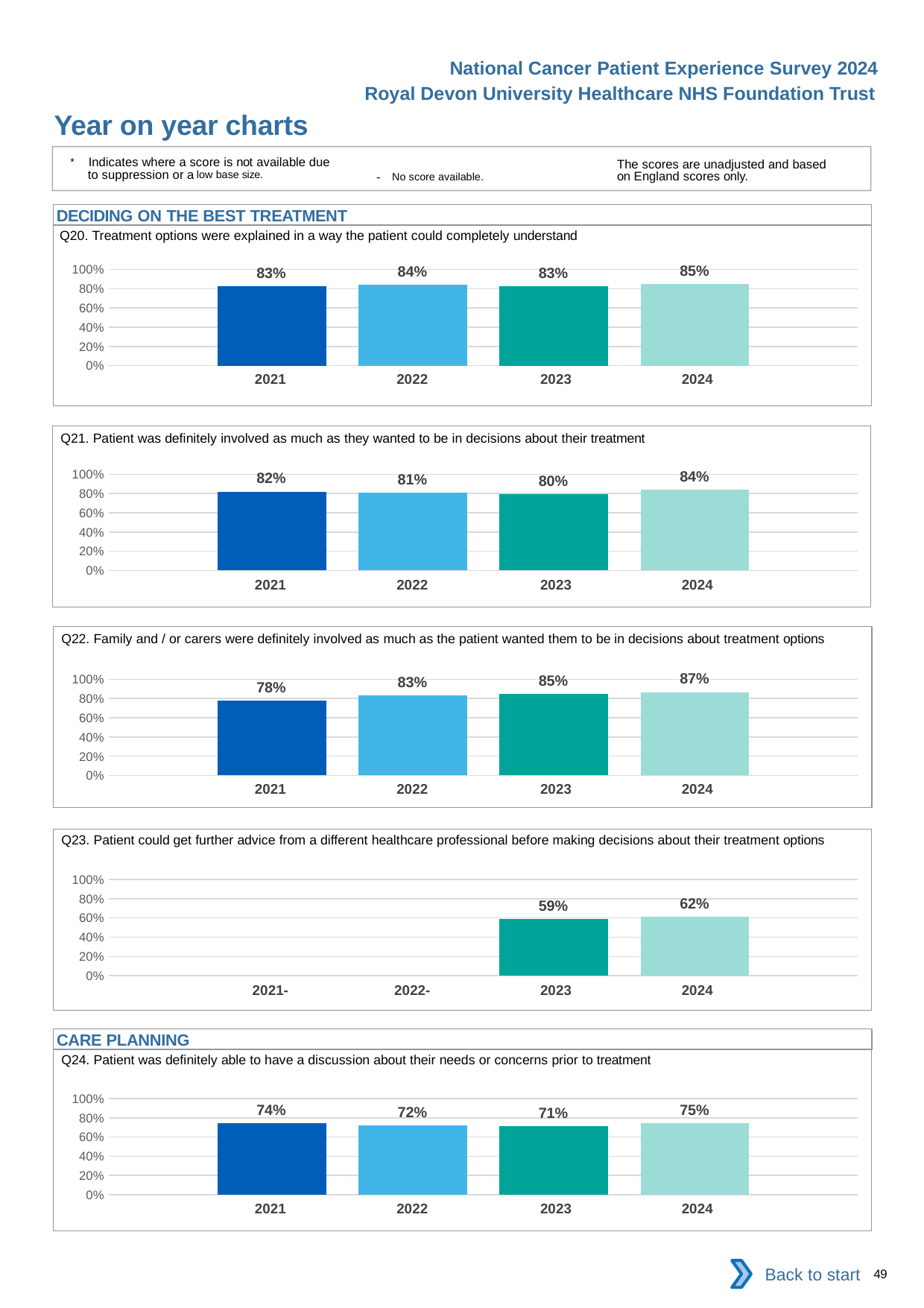
In the Q21 chart, which year has the lowest value? 2023 In the Q24 chart, which year has the highest value? 2024 Which section heading appears above the Q24 chart? CARE PLANNING In the Q23 chart, what is the value for 2023? 59% In the Q20 chart, what is the value for 2024? 85% In the Q23 chart, how many years have a bar plotted? 2 In the Q21 chart, what is the difference between the 2024 and 2023 values? 4% In the Q22 chart, what is the difference between the 2024 and 2021 values? 9% In the Q22 chart, do the values rise or fall from 2021 to 2024? rise What kind of chart is used for Q20? bar chart In the Q24 chart, is the value for 2022 larger or smaller than the value for 2021? smaller In the Q20 chart, how many years are shown on the x axis? 4